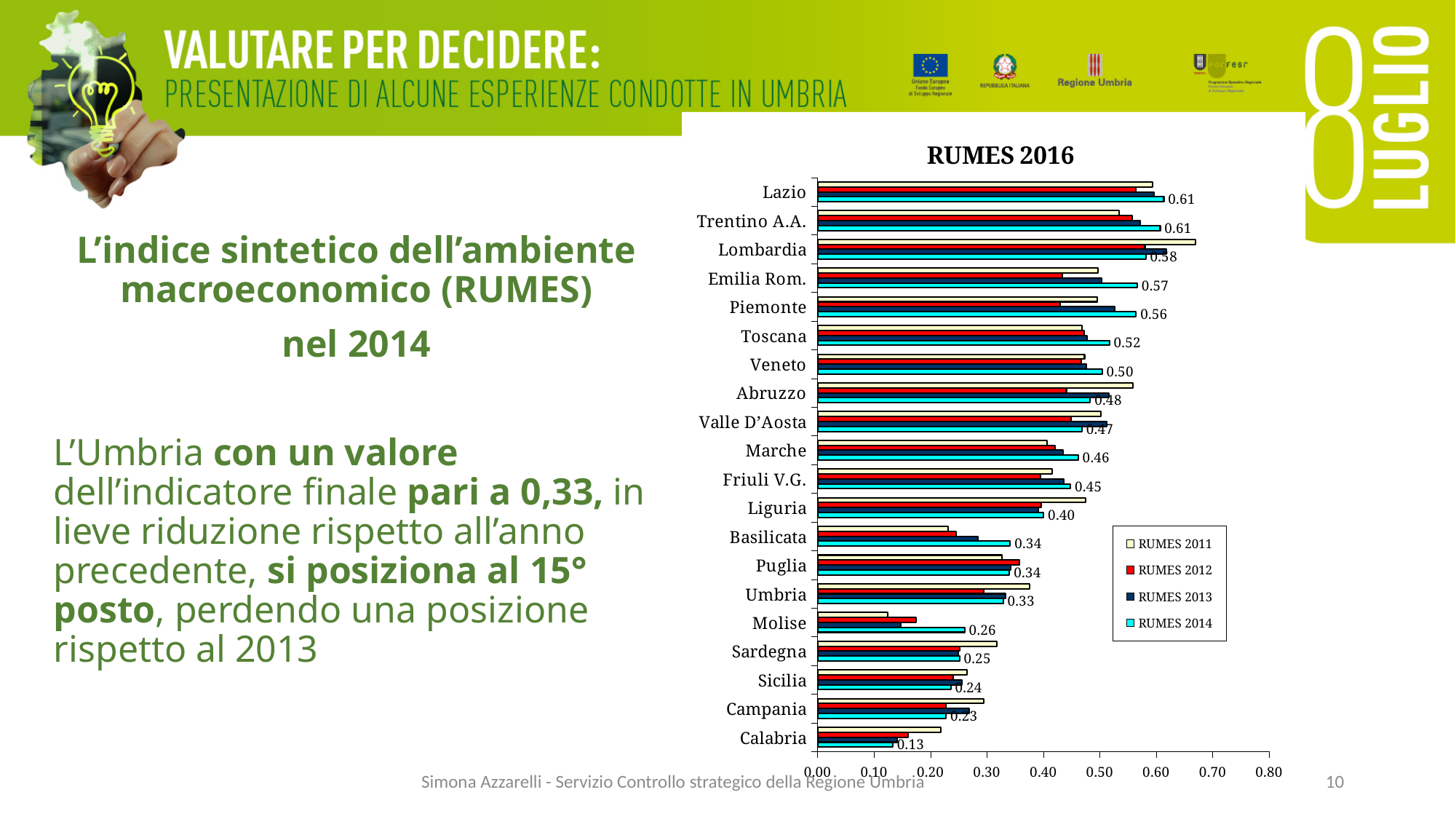
What is the RUMES 2014 value for Lombardia? 0.58 Is the RUMES 2011 value for Molise greater or less than 0.20? less Is the RUMES 2011 value for Lombardia greater or less than 0.60? greater Which region has the lowest RUMES 2014 value? Calabria How many series does the legend list? 4 What is the difference between the RUMES 2014 values of Lazio and Umbria? 0.28 How many regions are shown on the chart? 20 What is the RUMES 2014 value for Calabria? 0.13 What kind of chart is shown on the slide? Bar chart Which has the larger RUMES 2014 value, Toscana or Veneto? Toscana What is the title of the chart? RUMES 2016 What is the RUMES 2014 value for Umbria? 0.33